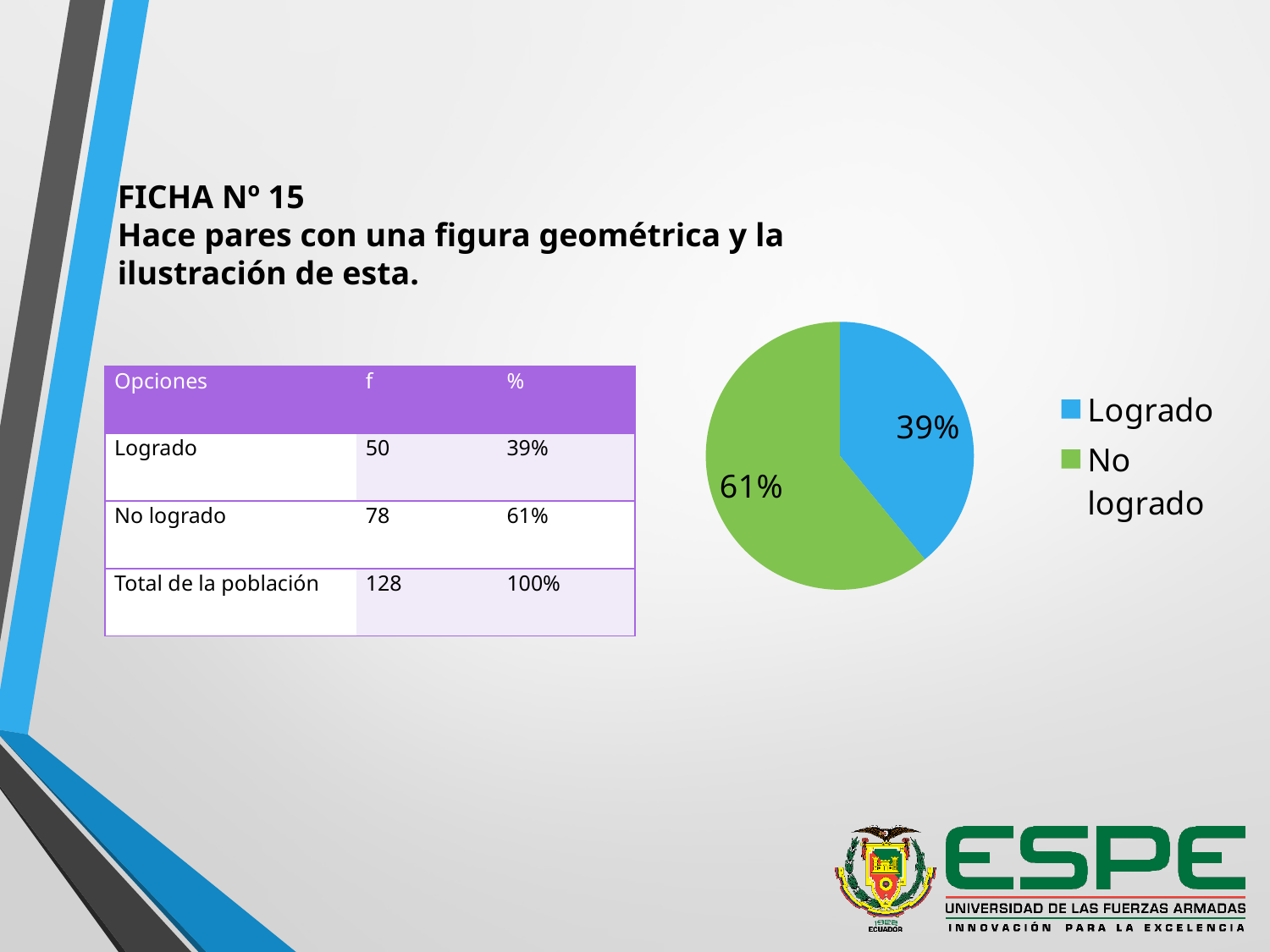
What share of the pie does the No logrado slice represent? 61% What colour is the Logrado slice in the pie chart? blue What colour is the No logrado slice in the pie chart? green What is the difference in percentage points between No logrado and Logrado in the pie chart? 22 Which is larger in the pie chart, Logrado or No logrado? No logrado Which slice of the pie chart is the smallest? Logrado How many entries does the pie chart legend list? 2 Which slice of the pie chart is the largest? No logrado How many slices does the pie chart have? 2 What percentage does the pie chart show for Logrado? 39% What kind of chart is shown on the slide? pie chart What percentage does the pie chart show for No logrado? 61%